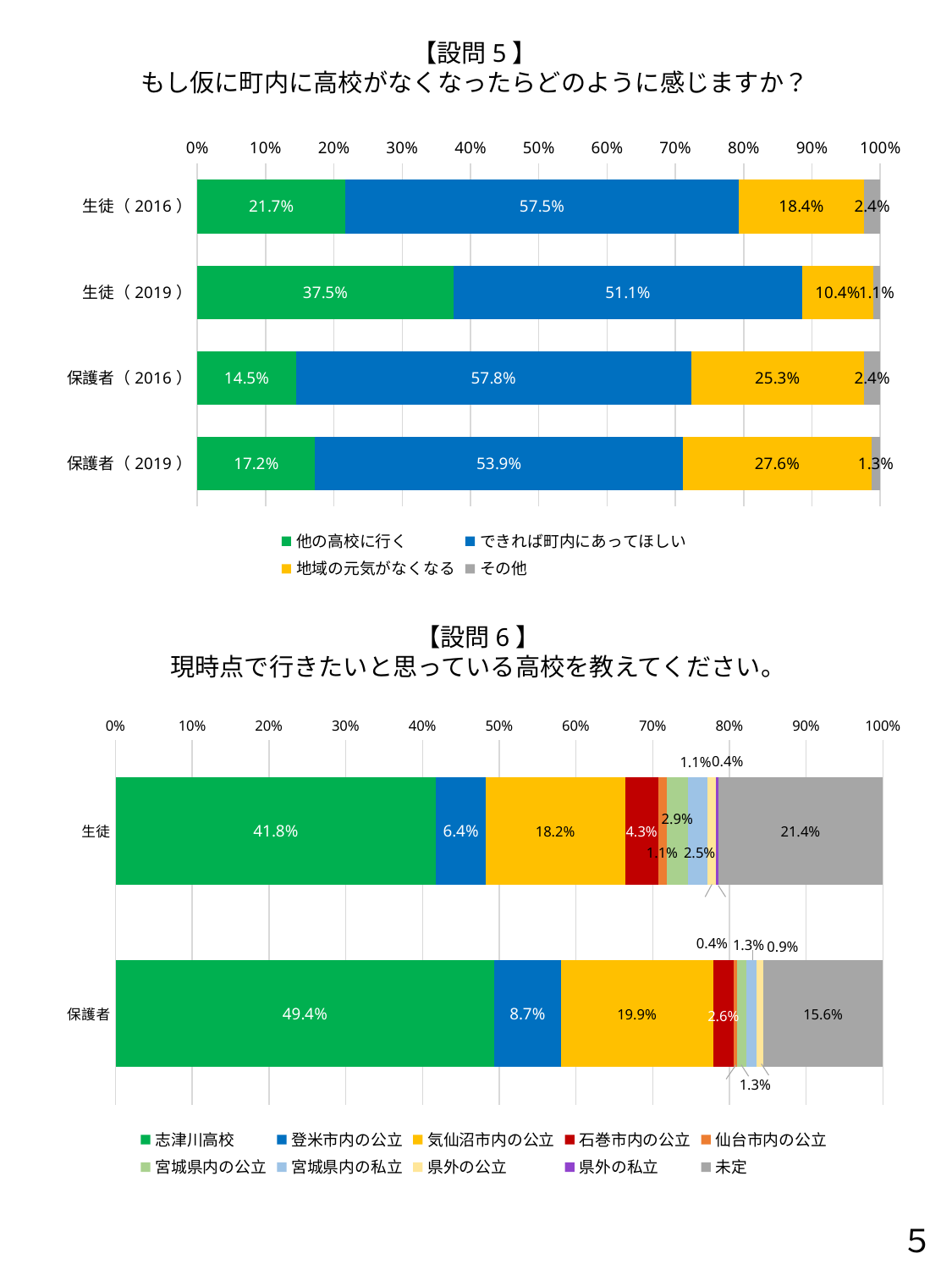
In the 【設問5】 chart, what percentage of 保護者（2016） chose できれば町内にあってほしい? 57.8% In the 【設問5】 chart, how many series does the legend list? 4 In the 【設問6】 chart, which is larger: the 気仙沼市内の公立 value for 生徒 or for 保護者? 保護者 In the 【設問6】 chart, what percentage of 保護者 chose 志津川高校? 49.4% In the 【設問5】 chart, which category has the highest value for 他の高校に行く? 生徒（2019） What kind of chart is the 【設問6】 chart? Stacked bar chart In the 【設問6】 chart, how many series does the legend list? 10 In the 【設問5】 chart, how many categories are plotted? 4 In the 【設問5】 chart, what is the difference between the 他の高校に行く values for 生徒（2019） and 生徒（2016）? 15.8% In the 【設問5】 chart, what percentage of 生徒（2019） chose 他の高校に行く? 37.5% In the 【設問6】 chart, what percentage of 生徒 chose 未定? 21.4% In the 【設問5】 chart, what percentage of 保護者（2019） chose 地域の元気がなくなる? 27.6%